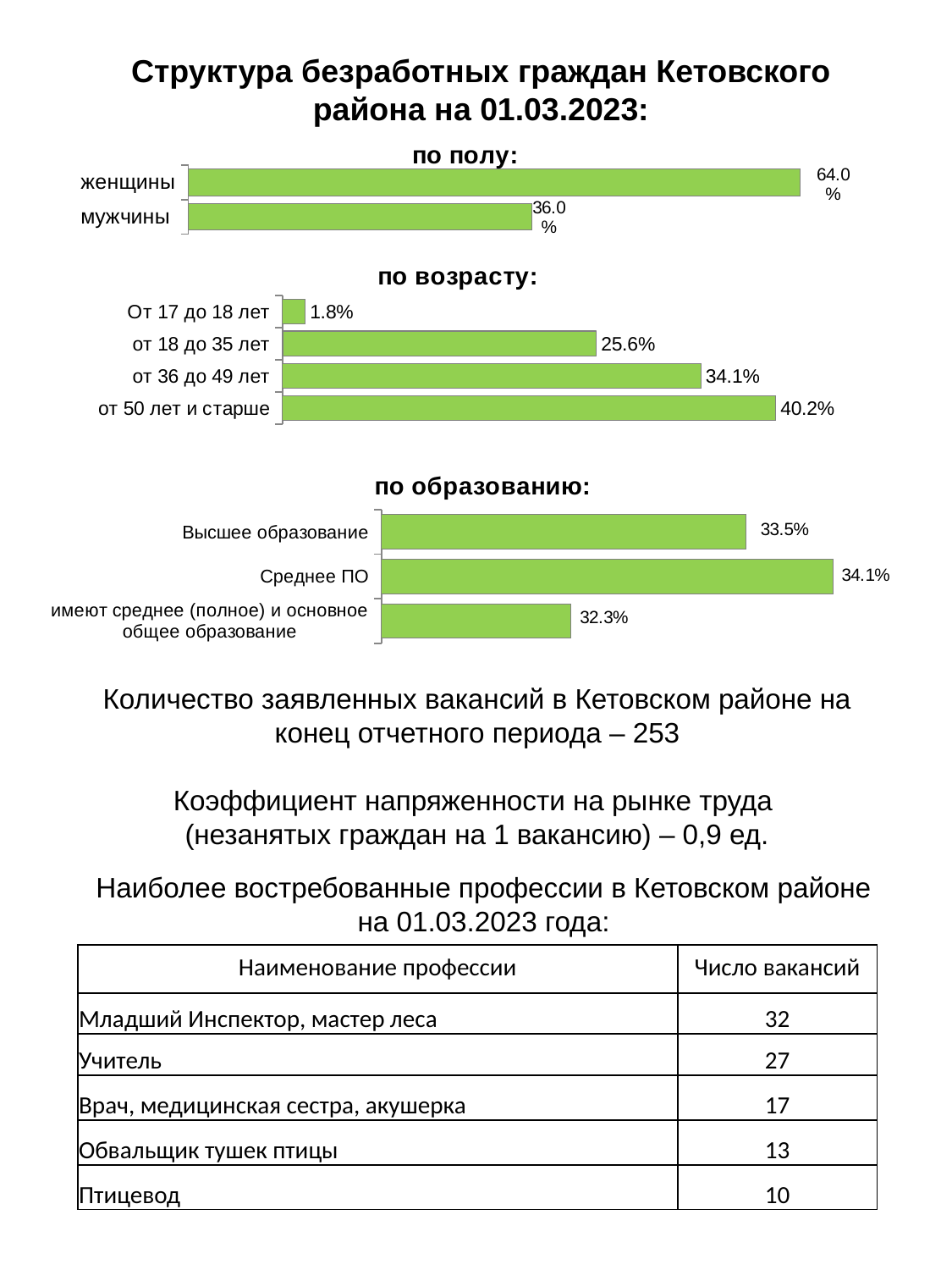
In the chart titled "по образованию:", which category has the highest value? Среднее ПО In the chart titled "по возрасту:", how many age categories are shown? 4 In the chart titled "по возрасту:", which age group has the lowest value? От 17 до 18 лет In the chart titled "по образованию:", what is the value for Высшее образование? 33.5% What type of chart is the chart titled "по полу:"? bar chart In the chart titled "по образованию:", which is larger: the value for Высшее образование or the value for имеют среднее (полное) и основное общее образование? Высшее образование In the chart titled "по возрасту:", what is the value for от 18 до 35 лет? 25.6% In the chart titled "по полу:", what is the difference between the values for женщины and мужчины? 28.0% In the chart titled "по полу:", what is the value for женщины? 64.0% In the chart titled "по возрасту:", do the values rise or fall going from the top category to the bottom category? rise In the chart titled "по возрасту:", what is the difference between the values for от 50 лет и старше and от 36 до 49 лет? 6.1% In the chart titled "по возрасту:", which age group has the highest value? от 50 лет и старше